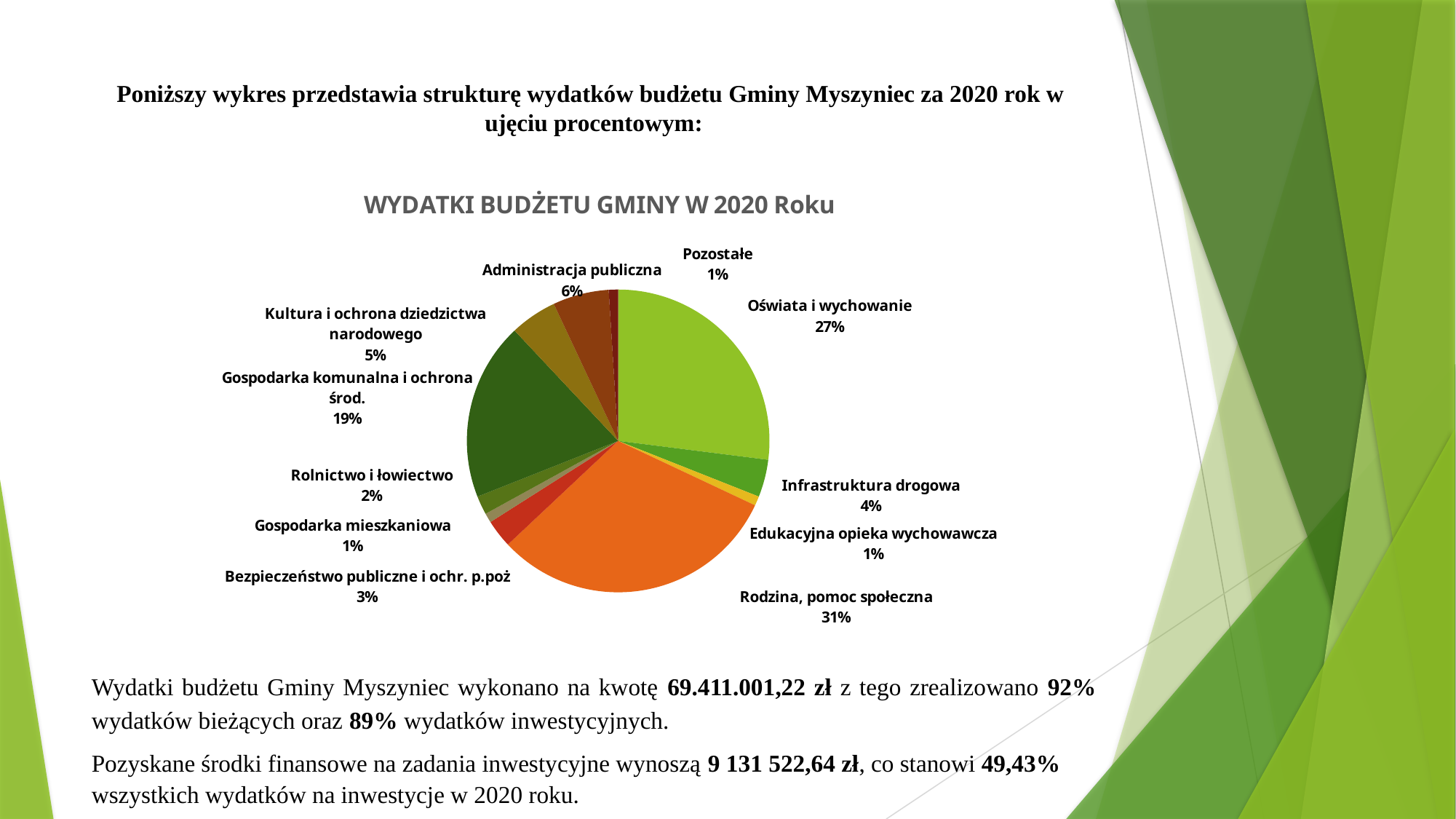
Which is larger: Gospodarka komunalna i ochrona środ. or Kultura i ochrona dziedzictwa narodowego? Gospodarka komunalna i ochrona środ. How many categories are shown in the pie chart? 11 What share of the pie does Rodzina, pomoc społeczna represent? 31% What percentage is shown for Administracja publiczna? 6% What type of chart is shown on the slide? pie chart What is the title of the chart? WYDATKI BUDŻETU GMINY W 2020 Roku What percentage is shown for Oświata i wychowanie? 27% What is the difference in percentage points between Rodzina, pomoc społeczna and Oświata i wychowanie? 4 Which category has the largest share of the pie? Rodzina, pomoc społeczna What percentage is shown for Gospodarka komunalna i ochrona środ.? 19% What percentage is shown for Bezpieczeństwo publiczne i ochr. p.poż? 3% What percentage is shown for Infrastruktura drogowa? 4%